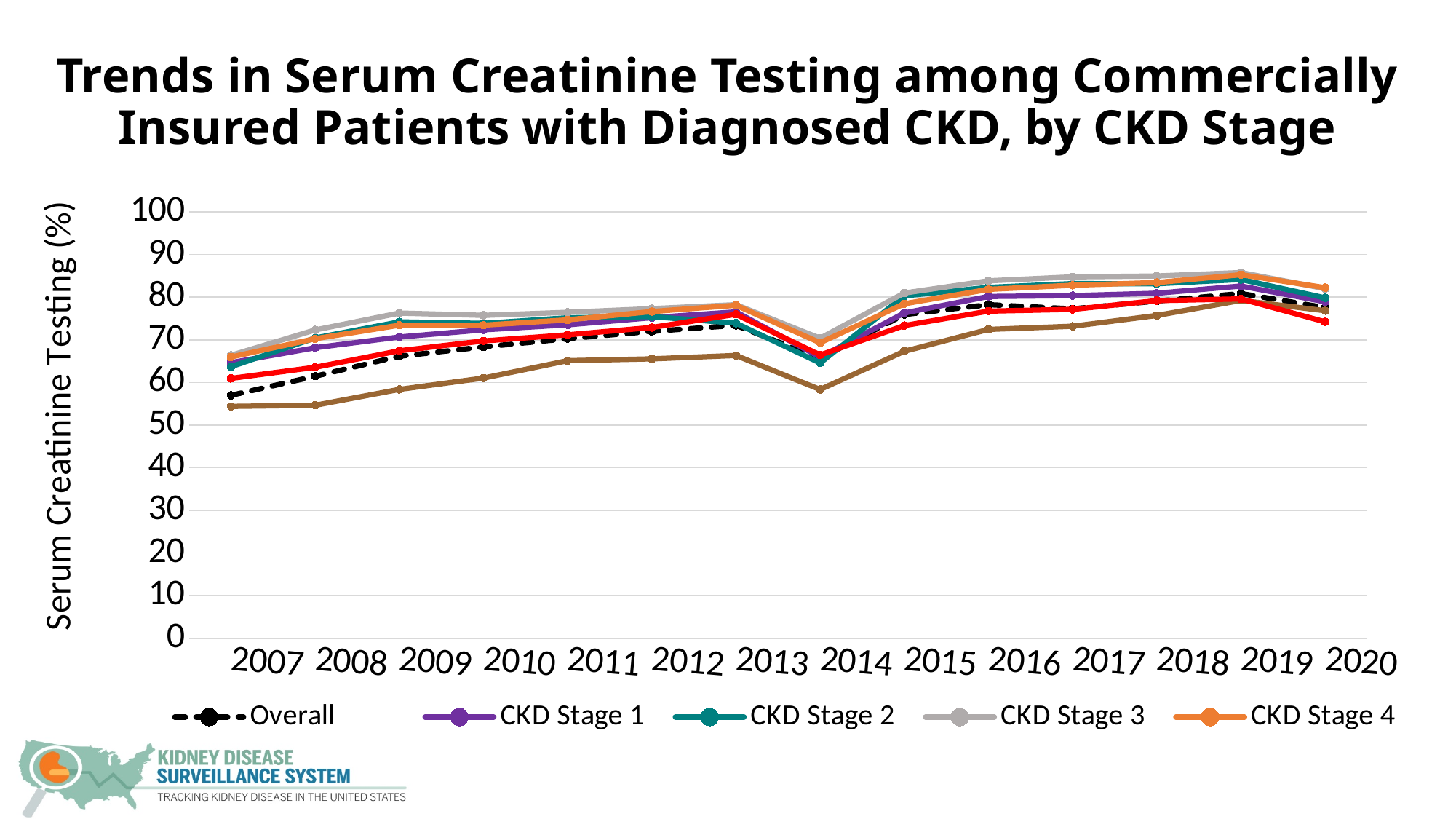
Is the value for CKD Stage 4 in 2020 greater or less than 80? greater Does the Overall series rise or fall from 2007 to 2013? rise What is the label of the y axis? Serum Creatinine Testing (%) Is the value for CKD Stage 3 in 2007 greater or less than 60? greater In which year is the Overall series at its lowest value? 2007 What kind of chart is shown on the slide? line chart Is the value for Overall in 2007 greater or less than 60? less What is the title of the chart? Trends in Serum Creatinine Testing among Commercially Insured Patients with Diagnosed CKD, by CKD Stage Which is larger in 2007, the value for Overall or the value for CKD Stage 3? CKD Stage 3 How many series does the legend list? 5 How many years are plotted along the x axis? 14